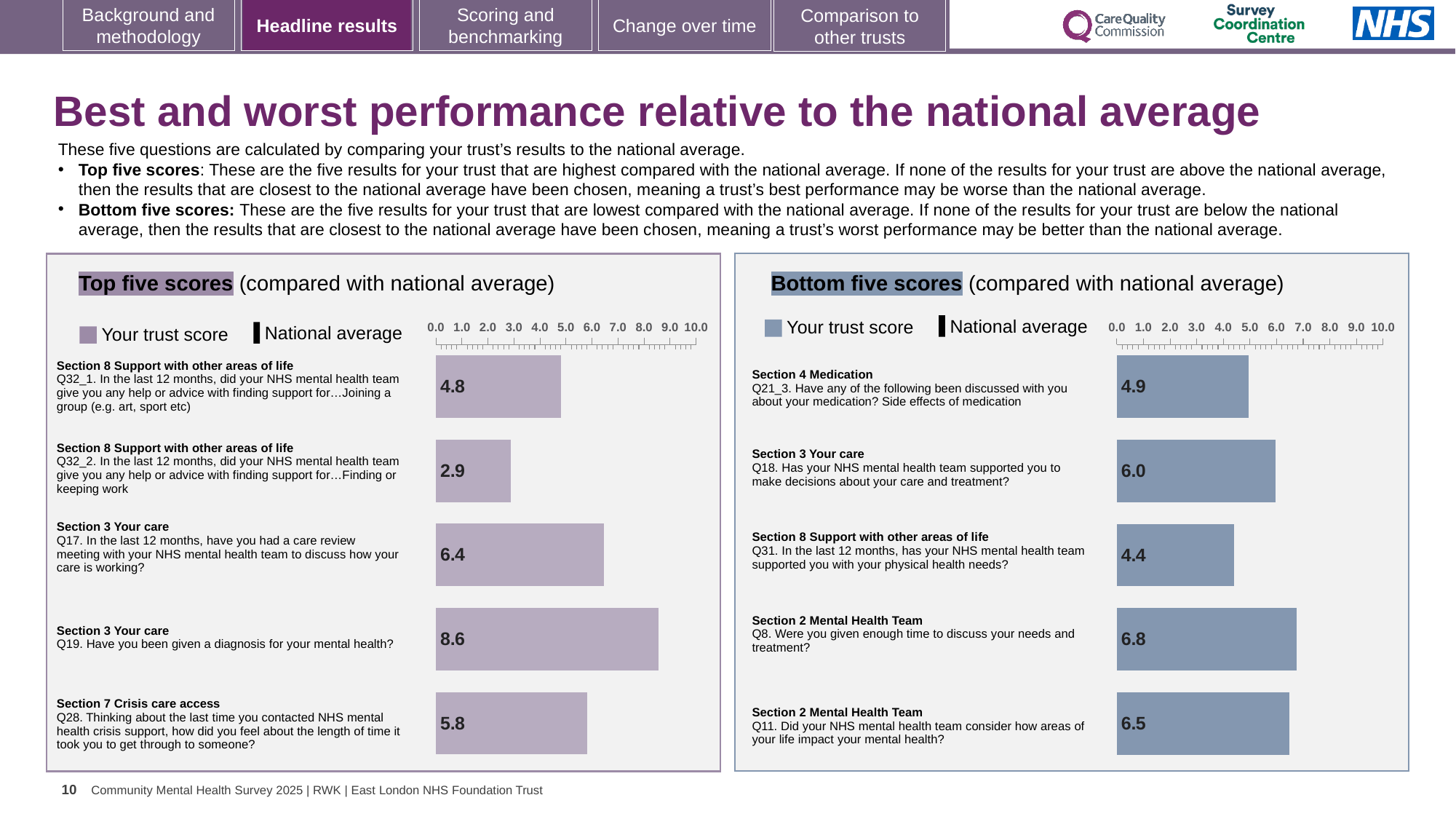
In the Top five scores chart, how many questions are plotted? 5 In the Bottom five scores chart, what is the trust score for Q31 (supported you with your physical health needs)? 4.4 In the Bottom five scores chart, which question has the highest trust score? Q8 What kind of chart is the Top five scores chart? Bar chart In the Top five scores chart, which question has the highest trust score? Q19 In the Top five scores chart, what is the trust score for Q32_2 (help or advice with finding or keeping work)? 2.9 In the Bottom five scores chart, which is larger, the trust score for Q21_3 or for Q11? Q11 In the Bottom five scores chart, what is the difference between the trust scores for Q8 and Q31? 2.4 In the Top five scores chart, what is the trust score for Q19 (Have you been given a diagnosis for your mental health?)? 8.6 In the Top five scores chart, what is the difference between the trust scores for Q19 and Q17? 2.2 In the Top five scores chart, which question has the lowest trust score? Q32_2 In the Bottom five scores chart, what is the trust score for Q18 (supported you to make decisions about your care and treatment)? 6.0